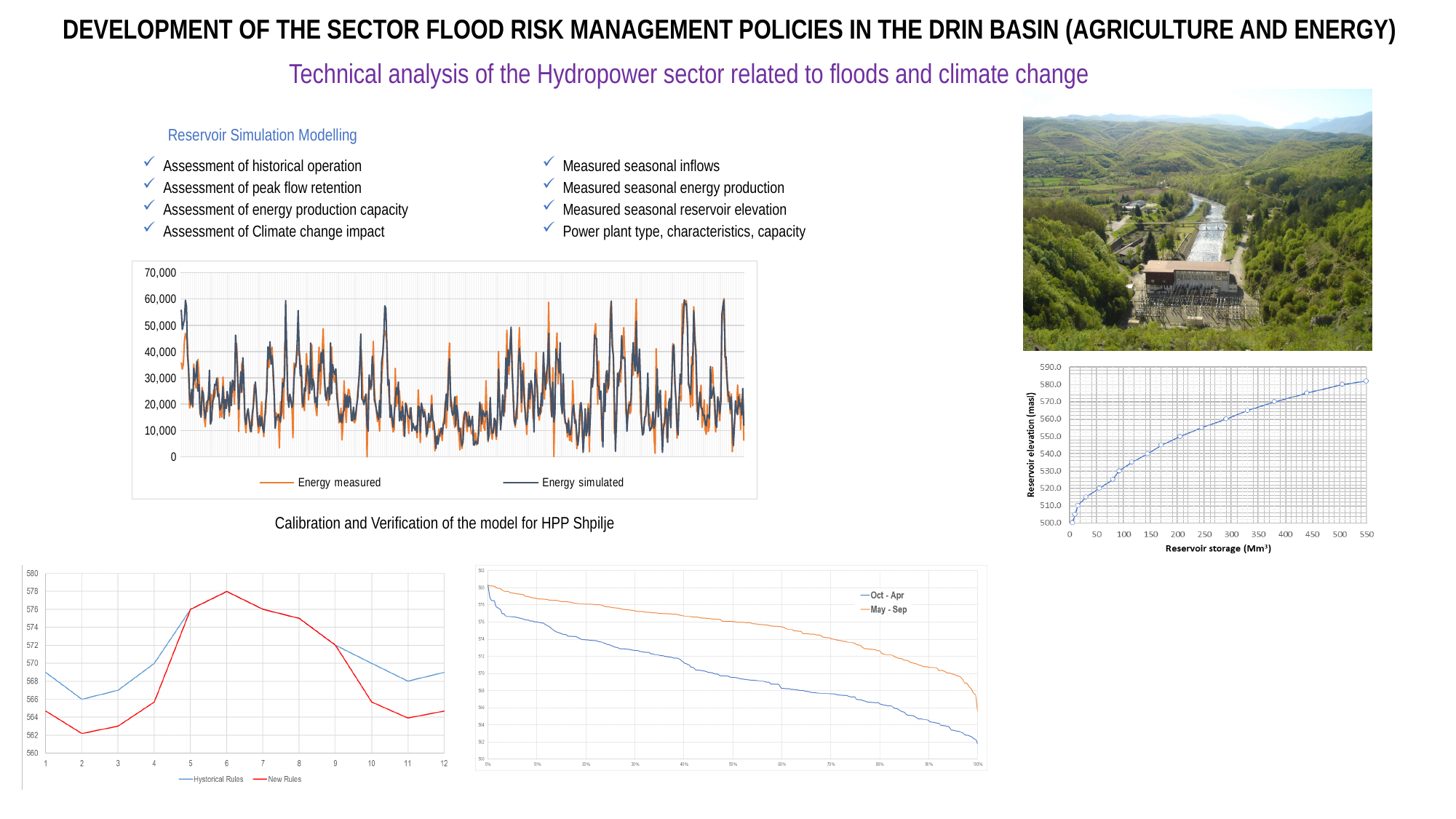
In the energy chart on the left (Calibration and Verification of the model for HPP Shpilje), how many series does the legend list? 2 In the bottom-left chart, at x = 1, which series has the larger value, Hystorical Rules or New Rules? Hystorical Rules In the bottom-left chart, at which x-axis value does the New Rules series reach its highest point? 6 In the energy chart on the left, what is the highest value shown on the vertical axis? 70,000 In the bottom-left chart, what is the value of the New Rules series at x = 6? 578 In the reservoir elevation chart on the right, is the elevation at a storage of 450 greater or less than 570? greater In the reservoir elevation chart on the right, does reservoir elevation rise or fall as reservoir storage increases? Rises In the reservoir elevation chart on the right, is the elevation at a storage of 100 greater or less than 540? less In the energy chart on the left, what are the two series named in the legend? Energy measured and Energy simulated In the reservoir elevation chart on the right, what is the label of the horizontal axis? Reservoir storage (Mm³) What kind of chart is the energy chart on the left of the slide? Line chart In the bottom-left chart (Hystorical Rules vs New Rules), how many points are plotted along the x axis for each series? 12